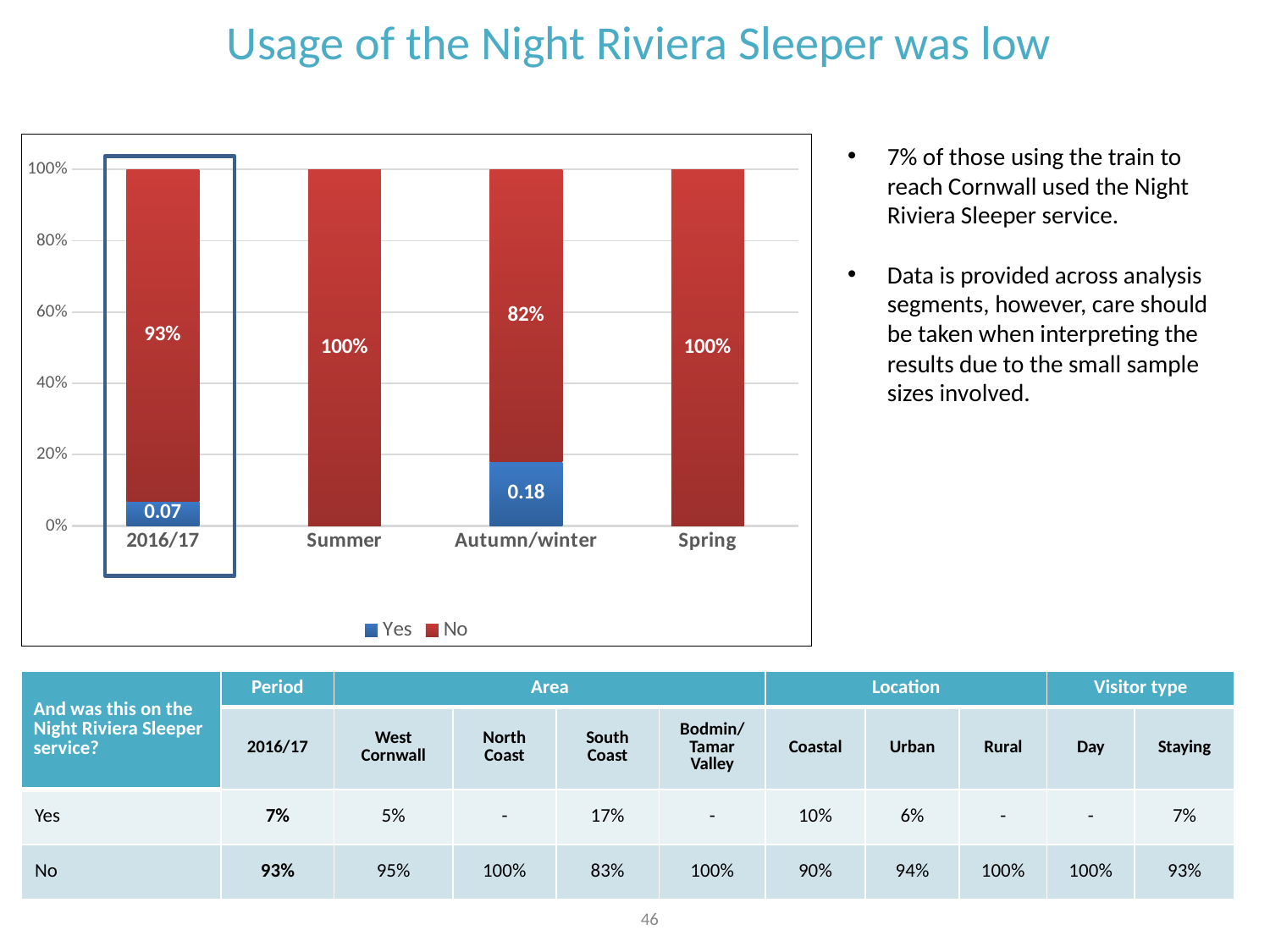
Which is larger, the Yes segment for Autumn/winter or the Yes segment for 2016/17? Autumn/winter Which category has the largest Yes segment? Autumn/winter What type of chart is shown on the slide? Stacked bar chart What is the data label on the No segment for 2016/17? 93% What is the data label on the Yes segment for 2016/17? 0.07 What is the data label on the Yes segment for Autumn/winter? 0.18 What is the difference between the No value for 2016/17 and the No value for Autumn/winter? 11 percentage points Which category has the smallest No segment? Autumn/winter What is the data label on the No segment for Summer? 100% Is the Yes segment for 2016/17 greater or less than 20%? less How many series does the chart legend list? 2 How many categories are shown on the x axis of the chart? 4